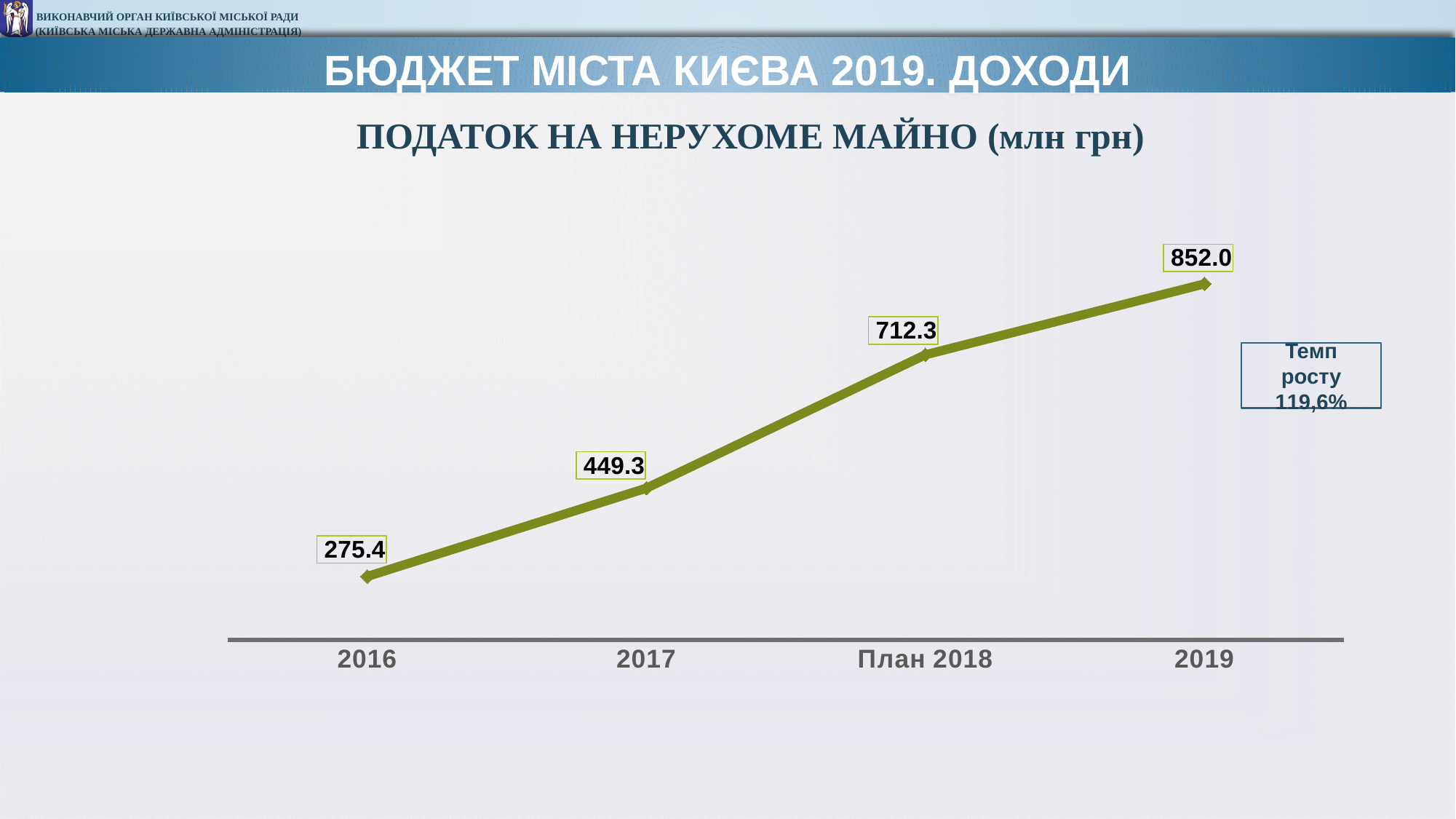
Which category has the highest value? 2019 What is the difference between the values for 2019 and План 2018? 139.7 How many data points are plotted on the chart? 4 What is the value for 2016? 275.4 What is the value for 2017? 449.3 What is the value for 2019? 852.0 Which is larger, the value for 2017 or the value for План 2018? План 2018 What is the value for План 2018? 712.3 Do the values rise or fall from 2016 to 2019? rise Which category has the lowest value? 2016 What kind of chart is shown on the slide? line chart What is the difference between the values for 2017 and 2016? 173.9